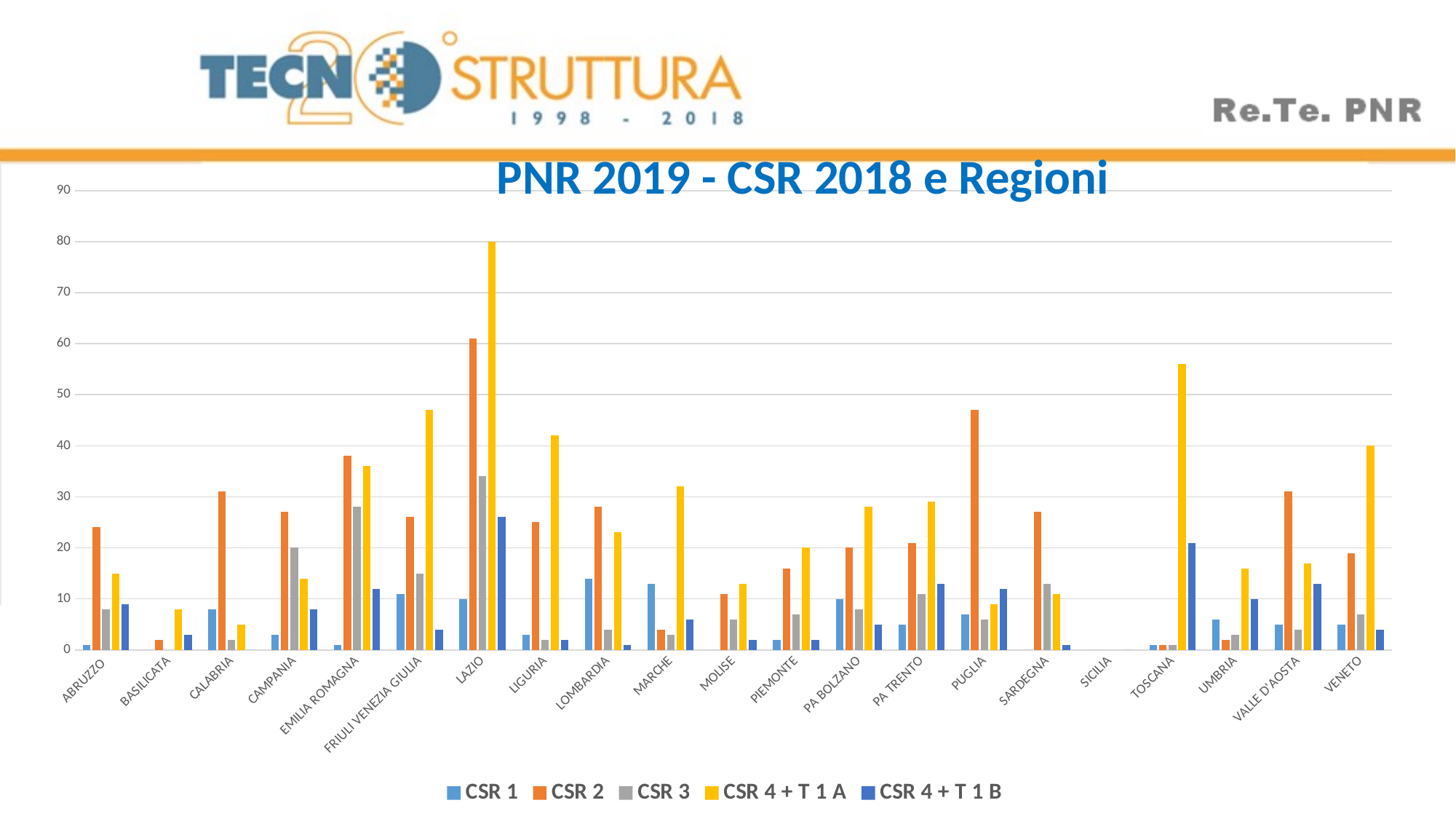
What is the title of the chart? PNR 2019 - CSR 2018 e Regioni What kind of chart is shown on the slide? bar chart How many regions (categories) are shown on the x axis? 21 How many series does the legend list? 5 Is the value for CSR 2 in PUGLIA greater or less than 40? greater Which is larger: the CSR 4 + T 1 A value for TOSCANA or for VENETO? TOSCANA Which region has the highest value for CSR 4 + T 1 B? LAZIO Is the value for CSR 2 in EMILIA ROMAGNA greater or less than 30? greater Which region has the highest value for CSR 2? LAZIO Which region shows no bars at all? SICILIA Which region has the tallest bar in the whole chart? LAZIO Is the value for CSR 4 + T 1 A in TOSCANA greater or less than 50? greater